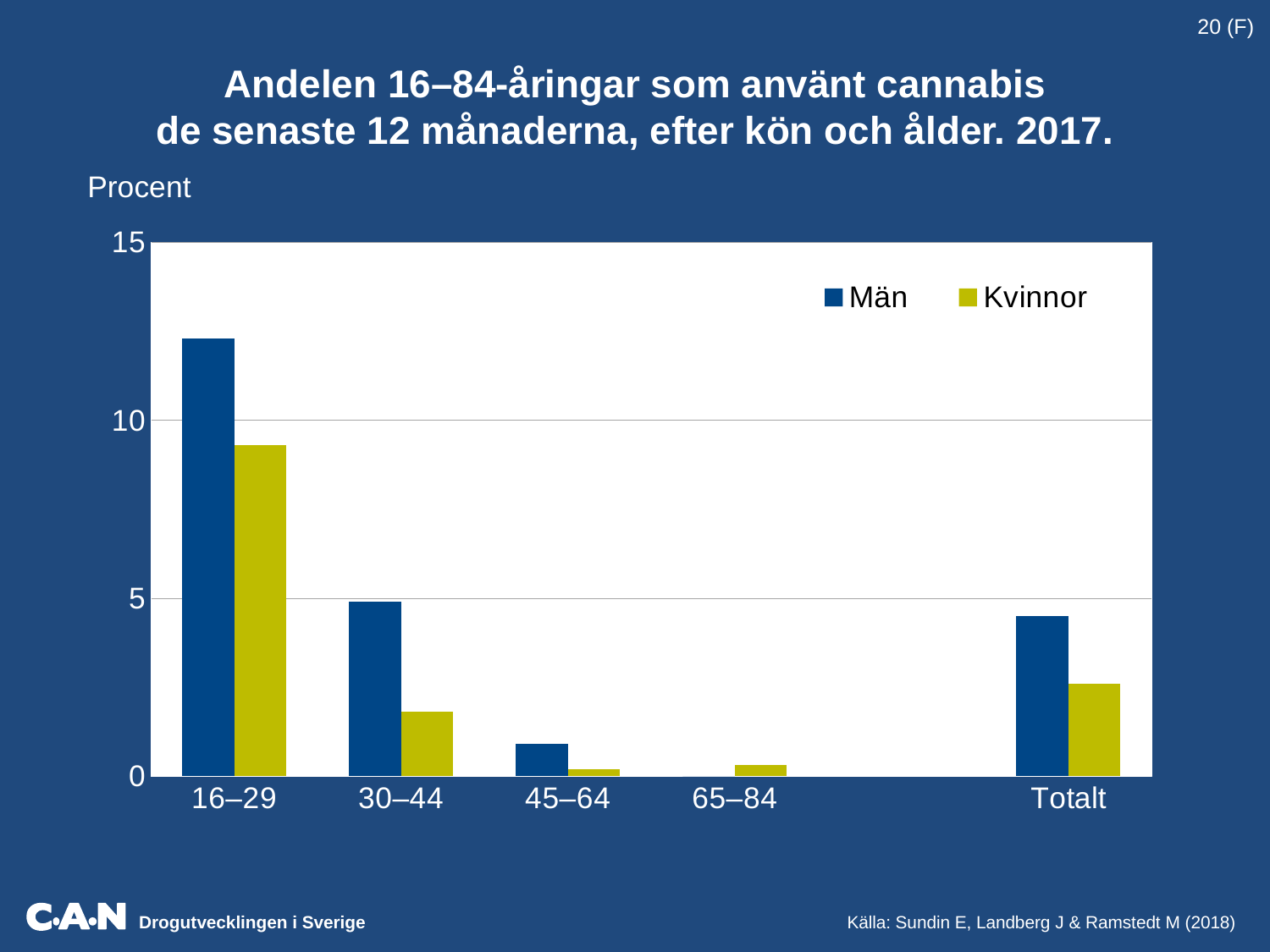
Which age group has the lowest value for Kvinnor? 45–64 What are the two series named in the legend? Män and Kvinnor How many categories are shown on the x axis? 5 What kind of chart is shown on the slide? bar chart How many series does the legend list? 2 Is the value for Kvinnor in the 16–29 age group greater or less than 10? less Which age group has the highest value for Kvinnor? 16–29 Which age group has the highest value for Män? 16–29 Do the values for Män rise or fall across the age groups from 16–29 to 65–84? fall Is the value for Män in the 16–29 age group greater or less than 10? greater In the Totalt category, which is larger, Män or Kvinnor? Män